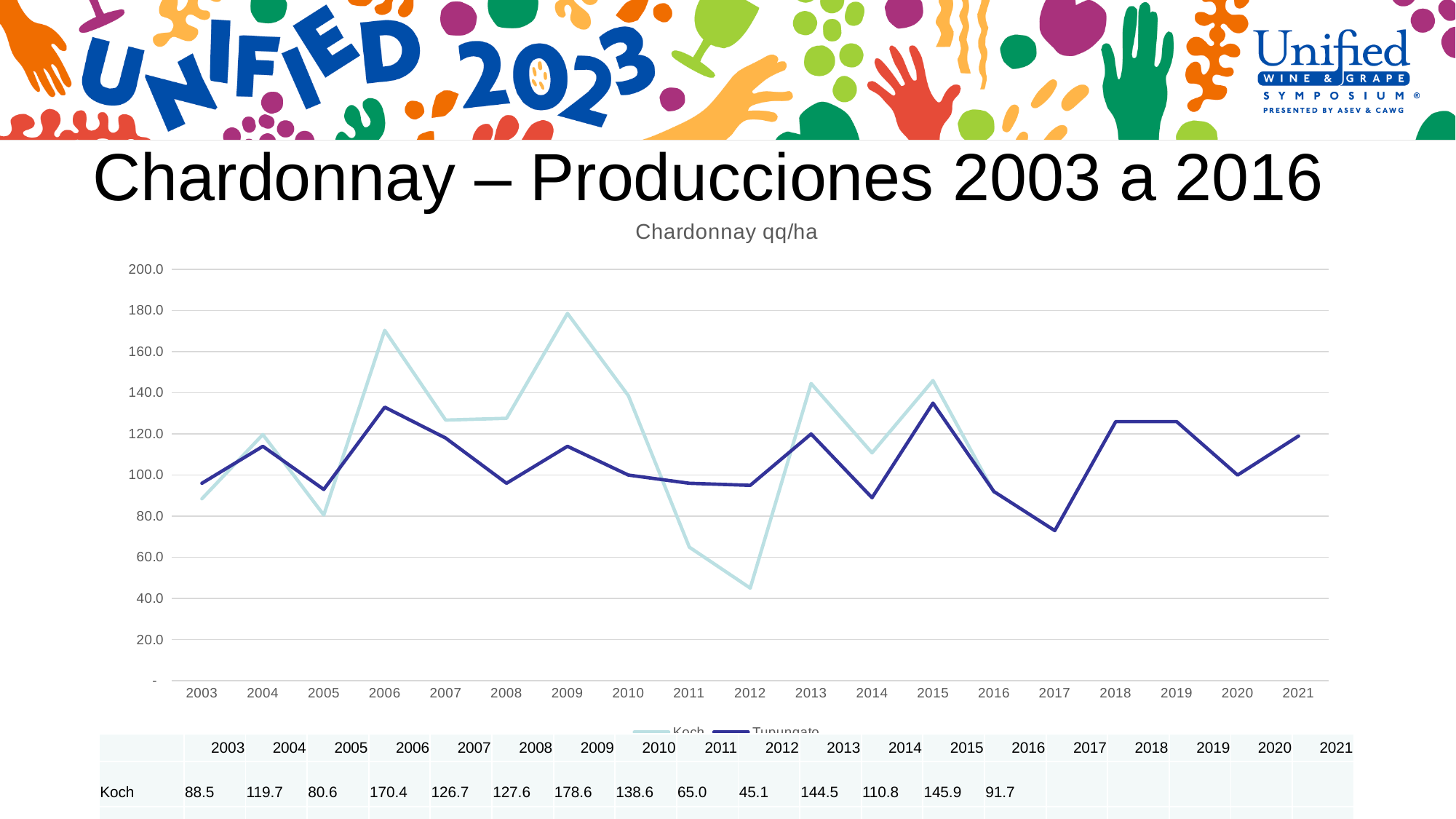
Is the Tupungato value for 2018 greater or less than 120? greater What kind of chart is shown on the slide? line chart How many series does the chart's legend list? 2 In which year is the Koch value lowest? 2012 How many years are shown on the x axis of the chart? 19 In which year is the Koch value highest? 2009 What is the Koch value for 2012? 45.1 What is the Koch value for 2009? 178.6 Which year has the larger Koch value, 2013 or 2014? 2013 Is the Tupungato value for 2017 greater or less than 80? less What is the Koch value for 2016? 91.7 What is the difference between the Koch values for 2006 and 2005? 89.8